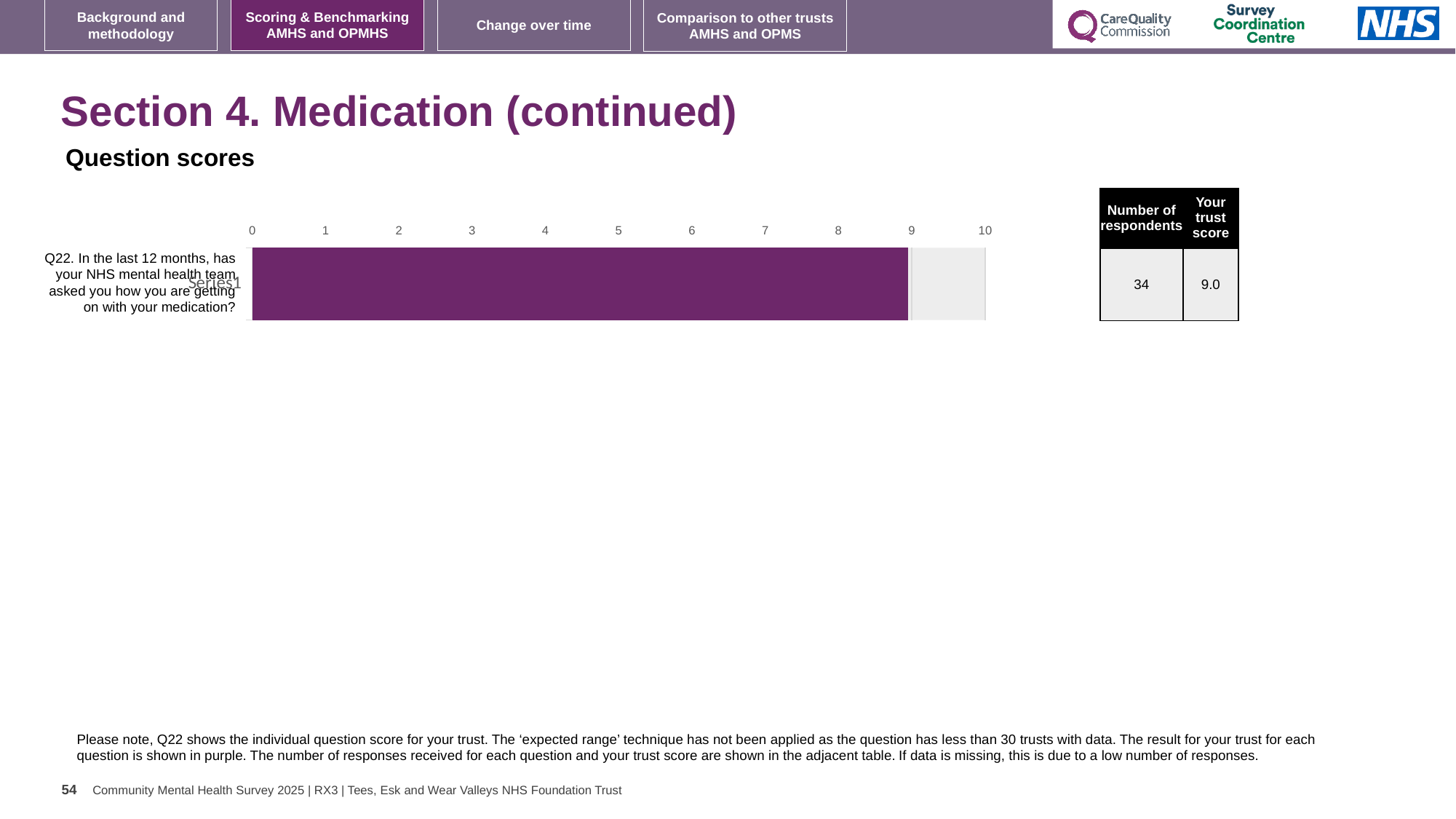
How many respondents are listed for Q22 in the adjacent table? 34 Is the value for Q22 greater or less than 8? greater Is the value for Q22 greater or less than 5? greater What colour is the bar for Q22? purple How many questions (categories) are plotted on the chart? 1 What is the maximum value shown on the chart's axis? 10 Is the value for Q22 greater or less than 10? less What kind of chart is shown on the slide? bar chart What is the trust score for Q22 shown on the chart? 9.0